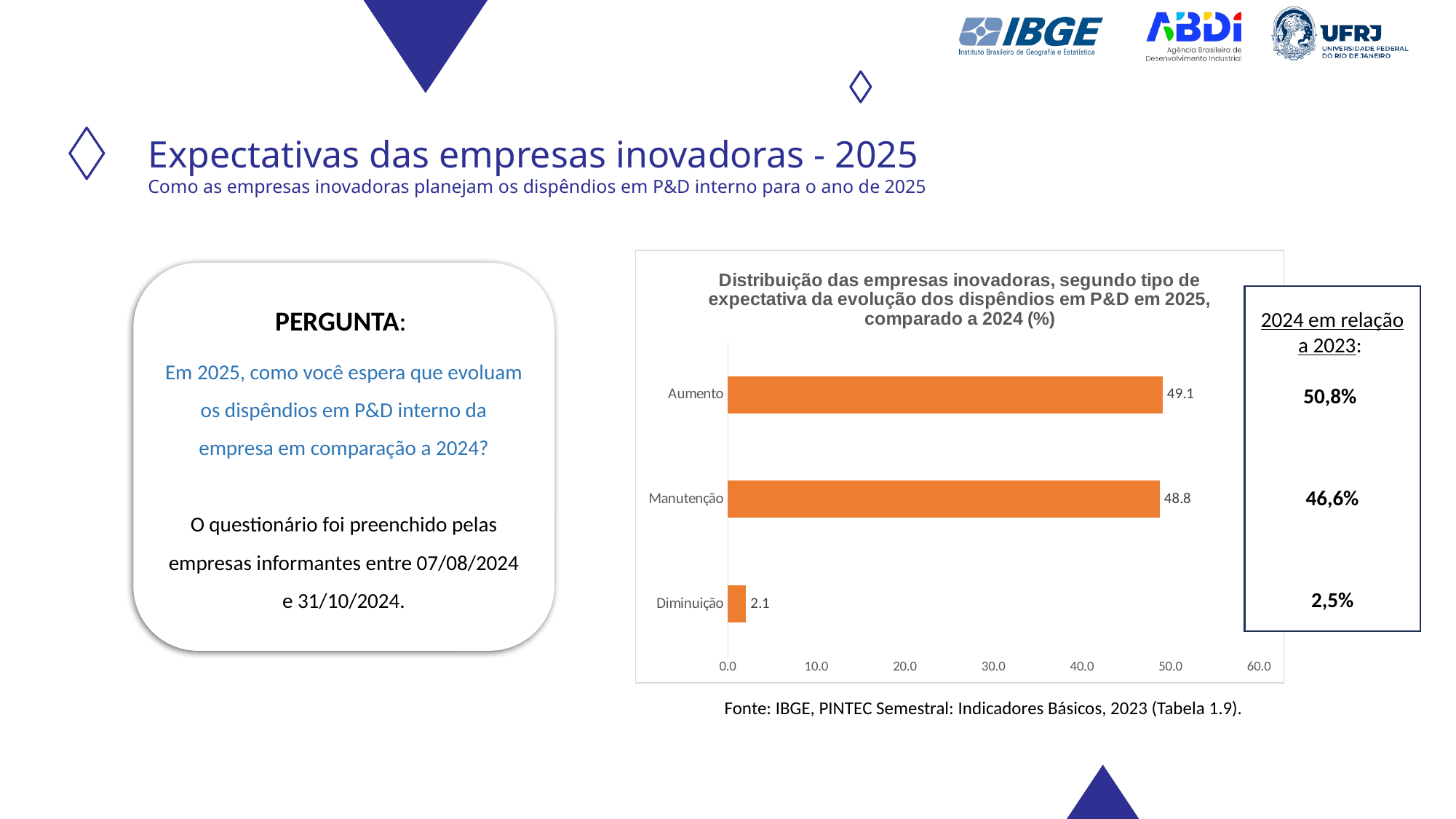
How many categories are shown in the chart? 3 What colour are the bars in the chart? orange Which is larger, the value for Manutenção or the value for Diminuição? Manutenção What is the value for Manutenção in the chart? 48.8 Which category has the highest value in the chart? Aumento What is the difference between the values for Aumento and Diminuição? 47.0 What kind of chart is shown on the slide? bar chart What is the value for Aumento in the chart? 49.1 Which category has the lowest value in the chart? Diminuição Is the value for Diminuição greater or less than 10.0? less What is the value for Diminuição in the chart? 2.1 What is the difference between the values for Aumento and Manutenção? 0.3